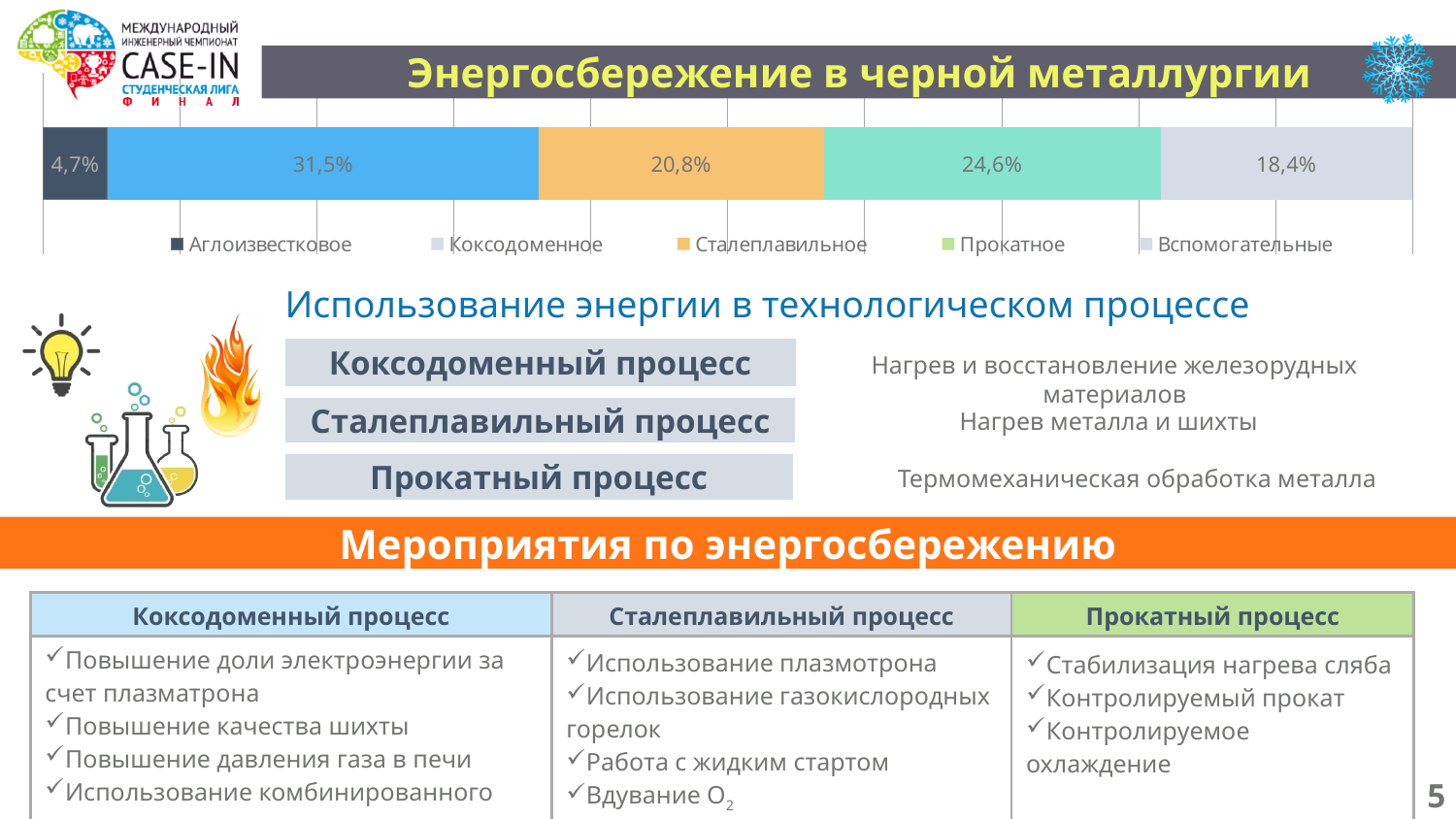
Which segment of the stacked bar has the highest value? Коксодоменное What is the value for Прокатное in the stacked bar chart? 24,6% Which segment of the stacked bar has the lowest value? Аглоизвестковое What kind of chart is shown at the top of the slide? Stacked bar chart What is the difference between the values for Коксодоменное and Сталеплавильное? 10,7% Which is larger, the value for Прокатное or the value for Вспомогательные? Прокатное What is the value for Аглоизвестковое in the stacked bar chart? 4,7% What is the value for Вспомогательные in the stacked bar chart? 18,4% What is the value for Коксодоменное in the stacked bar chart? 31,5% How many segments does the stacked bar contain? 5 What is the total of all segments in the stacked bar? 100% How many series does the chart legend list? 5